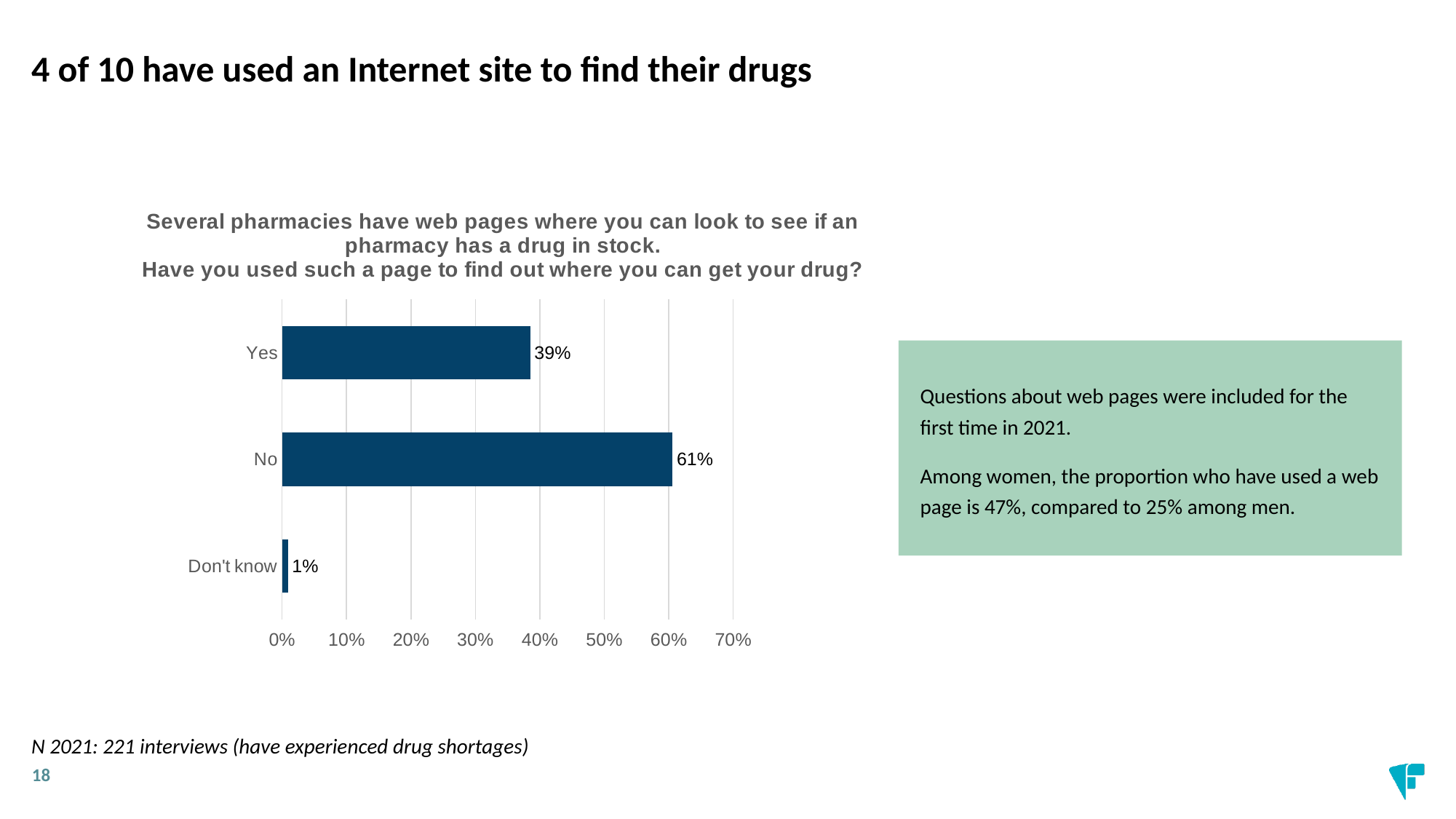
What percentage of respondents answered "Don't know"? 1% What is the total of the "Yes" and "No" values? 100% What is the highest value shown on the x axis of the chart? 70% Which is larger, the value for "Yes" or the value for "No"? No Is the value for "Yes" greater or less than 50%? less How many response categories are shown in the chart? 3 Which response category has the lowest value? Don't know What percentage of respondents answered "Yes"? 39% Which response category has the highest value? No What percentage of respondents answered "No"? 61% What is the difference between the "No" and "Yes" values? 22 percentage points What type of chart is shown on the slide? Bar chart